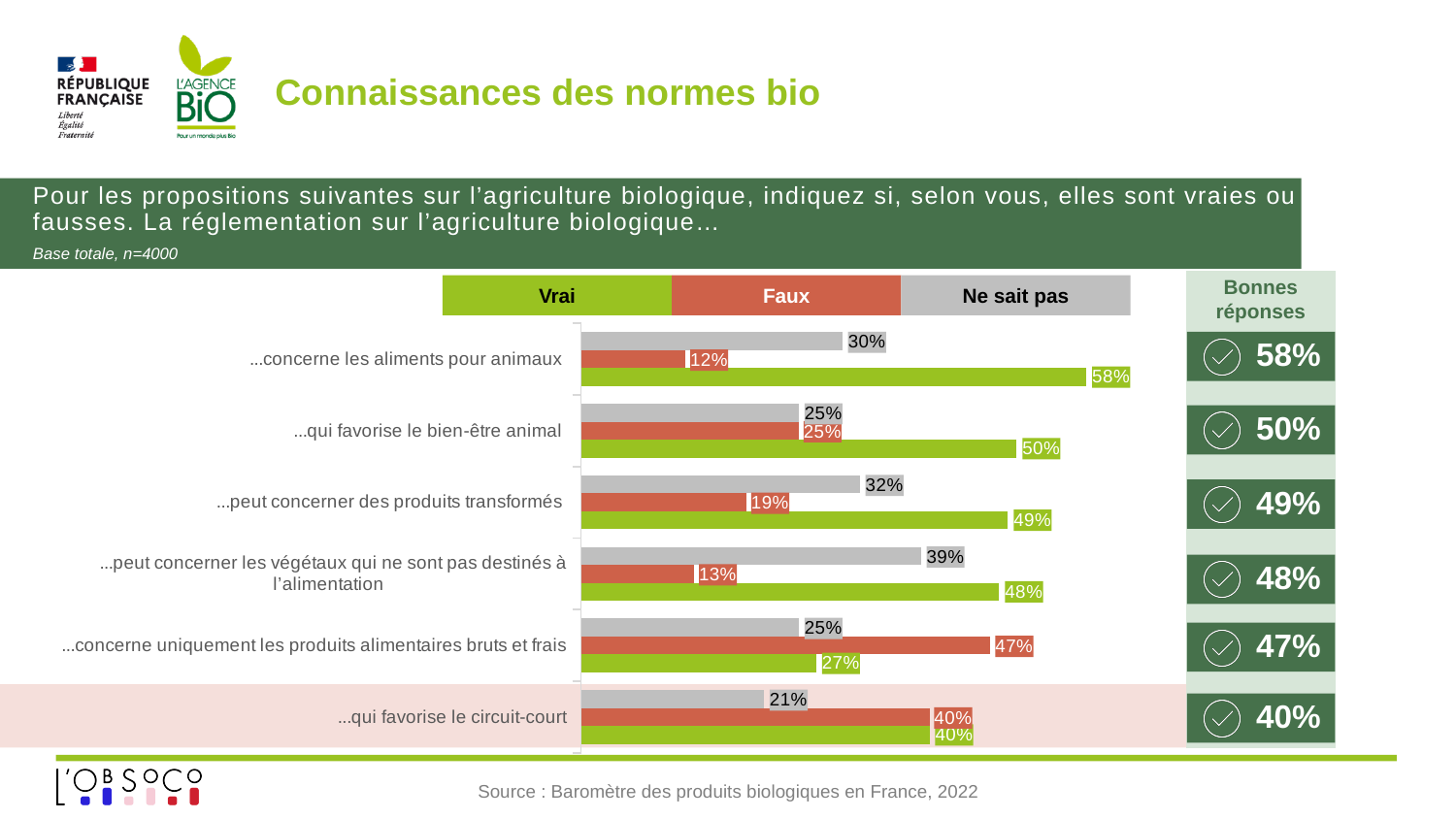
What is the difference between the "Vrai" and "Faux" percentages for "...peut concerner des produits transformés"? 30% What kind of chart is shown on the slide? Bar chart What percentage answered "Ne sait pas" for "...peut concerner les végétaux qui ne sont pas destinés à l'alimentation"? 39% What percentage answered "Vrai" for "...concerne les aliments pour animaux"? 58% What percentage answered "Faux" for "...concerne uniquement les produits alimentaires bruts et frais"? 47% How many propositions are listed in the chart? 6 How many series does the legend list? 3 Which proposition has the lowest "Faux" percentage? ...concerne les aliments pour animaux Which colour represents the "Faux" series in the chart? Red/orange Which proposition has the highest "Vrai" percentage? ...concerne les aliments pour animaux For "...concerne uniquement les produits alimentaires bruts et frais", which is larger: the "Vrai" or the "Faux" percentage? Faux What is the "Bonnes réponses" value for "...qui favorise le circuit-court"? 40%